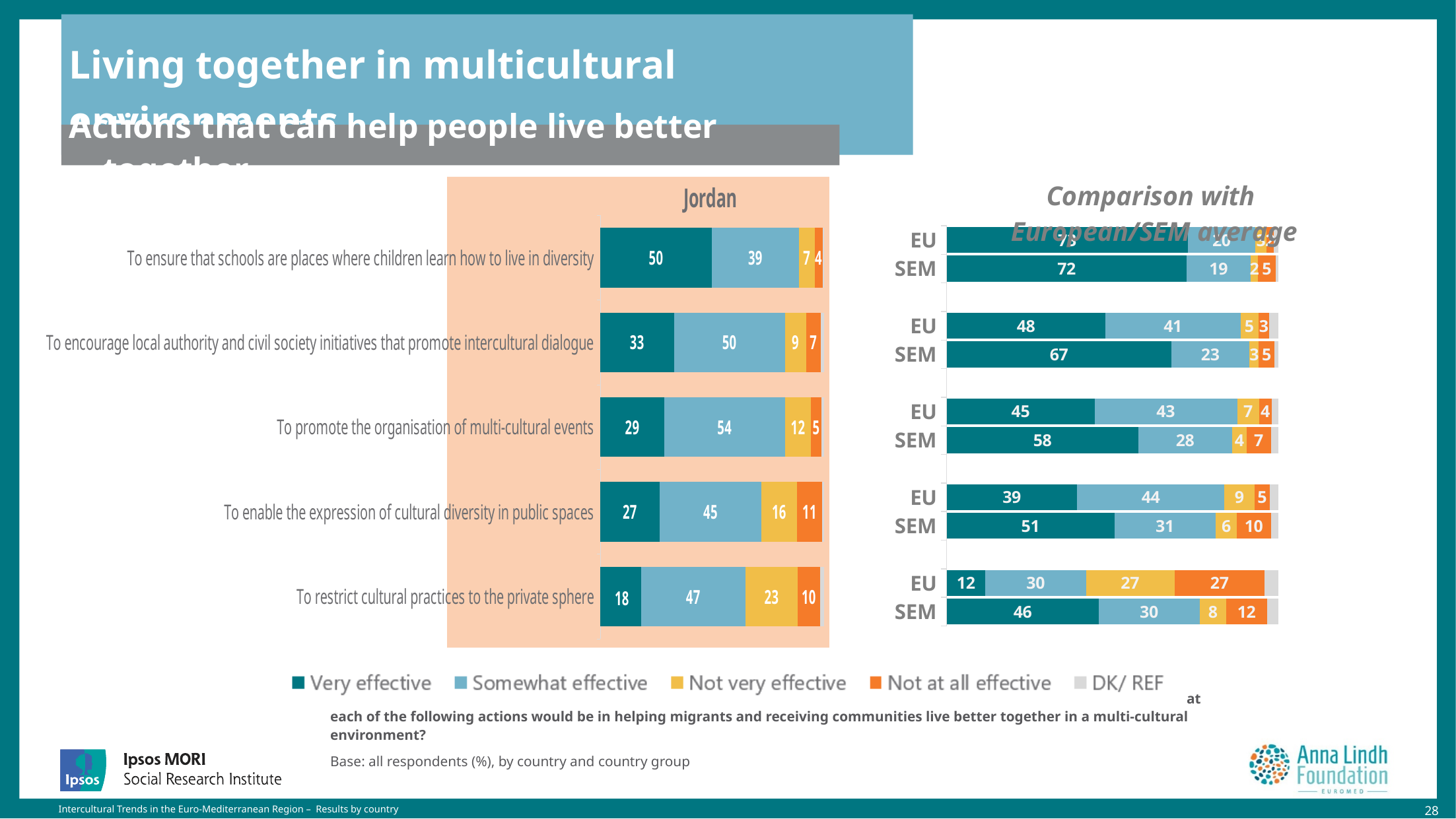
In the comparison chart, what is the SEM 'Very effective' value for the second action (encouraging local authority and civil society initiatives that promote intercultural dialogue)? 67 In the Jordan chart, what is the difference between the 'Very effective' values for ensuring schools teach living in diversity and for enabling the expression of cultural diversity in public spaces? 23 How many series does the legend list? 5 In the Jordan chart, is the 'Not at all effective' value larger for enabling the expression of cultural diversity in public spaces or for promoting the organisation of multi-cultural events? To enable the expression of cultural diversity in public spaces What kind of chart is the Jordan chart? Stacked bar chart In the Jordan chart, what is the 'Somewhat effective' value for promoting the organisation of multi-cultural events? 54 In the Jordan chart, which action has the lowest 'Very effective' value? To restrict cultural practices to the private sphere In the comparison chart, what is the EU 'Not at all effective' value for the last action (restricting cultural practices to the private sphere)? 27 In the Jordan chart, what percentage of respondents said ensuring that schools are places where children learn how to live in diversity is very effective? 50 In the Jordan chart, what is the 'Not very effective' value for restricting cultural practices to the private sphere? 23 How many actions are listed in the Jordan chart? 5 In the Jordan chart, which action has the highest 'Very effective' value? To ensure that schools are places where children learn how to live in diversity